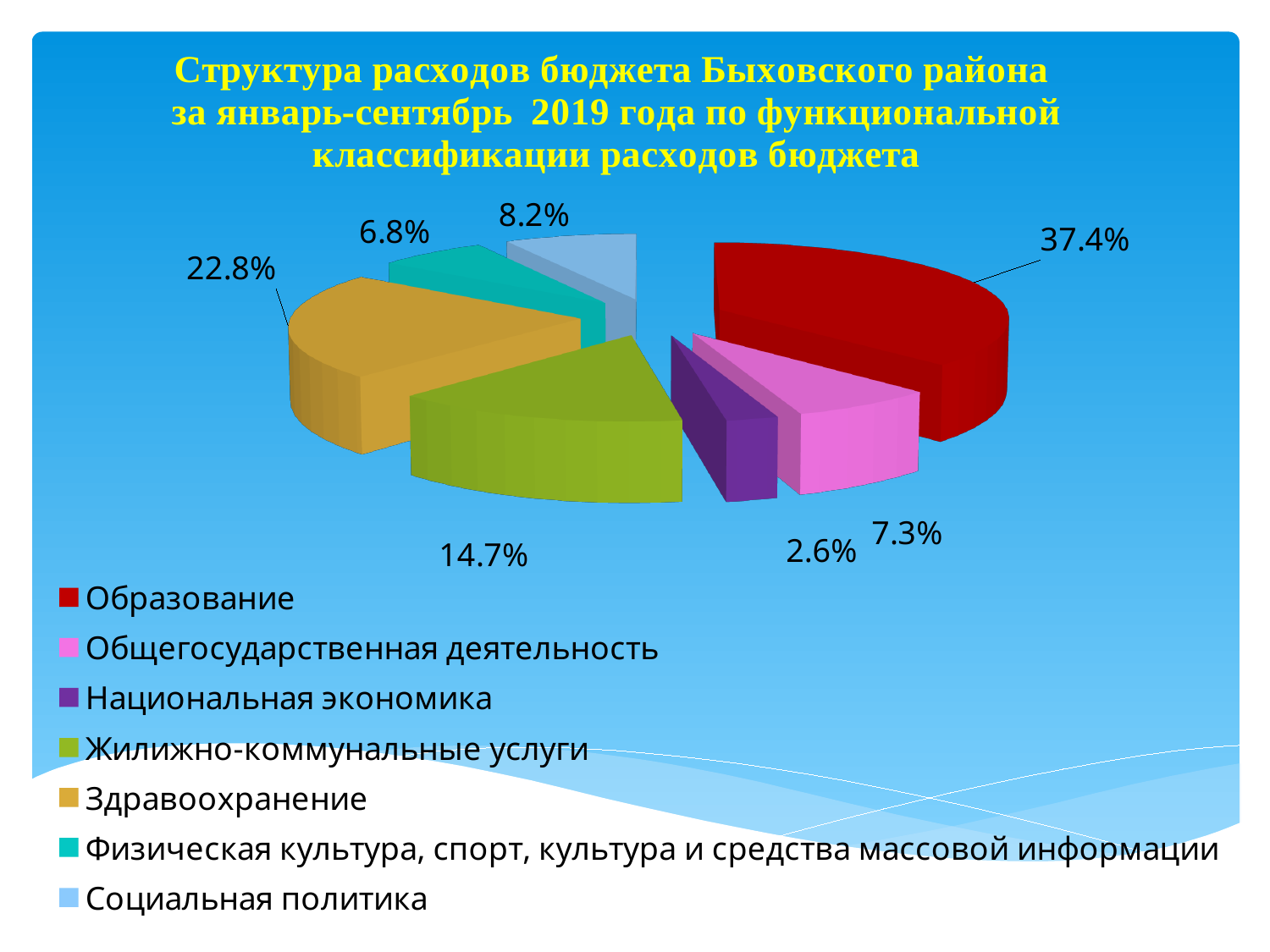
Which colour represents Физическая культура, спорт, культура и средства массовой информации in the chart? Teal What share of the budget expenditure goes to Национальная экономика? 2.6% What share of the budget expenditure goes to Жилищно-коммунальные услуги? 14.7% Which has a larger share: Общегосударственная деятельность or Социальная политика? Социальная политика What share of the budget expenditure goes to Социальная политика? 8.2% What is the difference between the shares for Образование and Здравоохранение? 14.6% How many categories are shown in the pie chart? 7 What share of the budget expenditure goes to Образование? 37.4% Which category has the smallest share of budget expenditure? Национальная экономика Which category has the largest share of budget expenditure? Образование What share of the budget expenditure goes to Здравоохранение? 22.8% What type of chart is shown on the slide? Pie chart